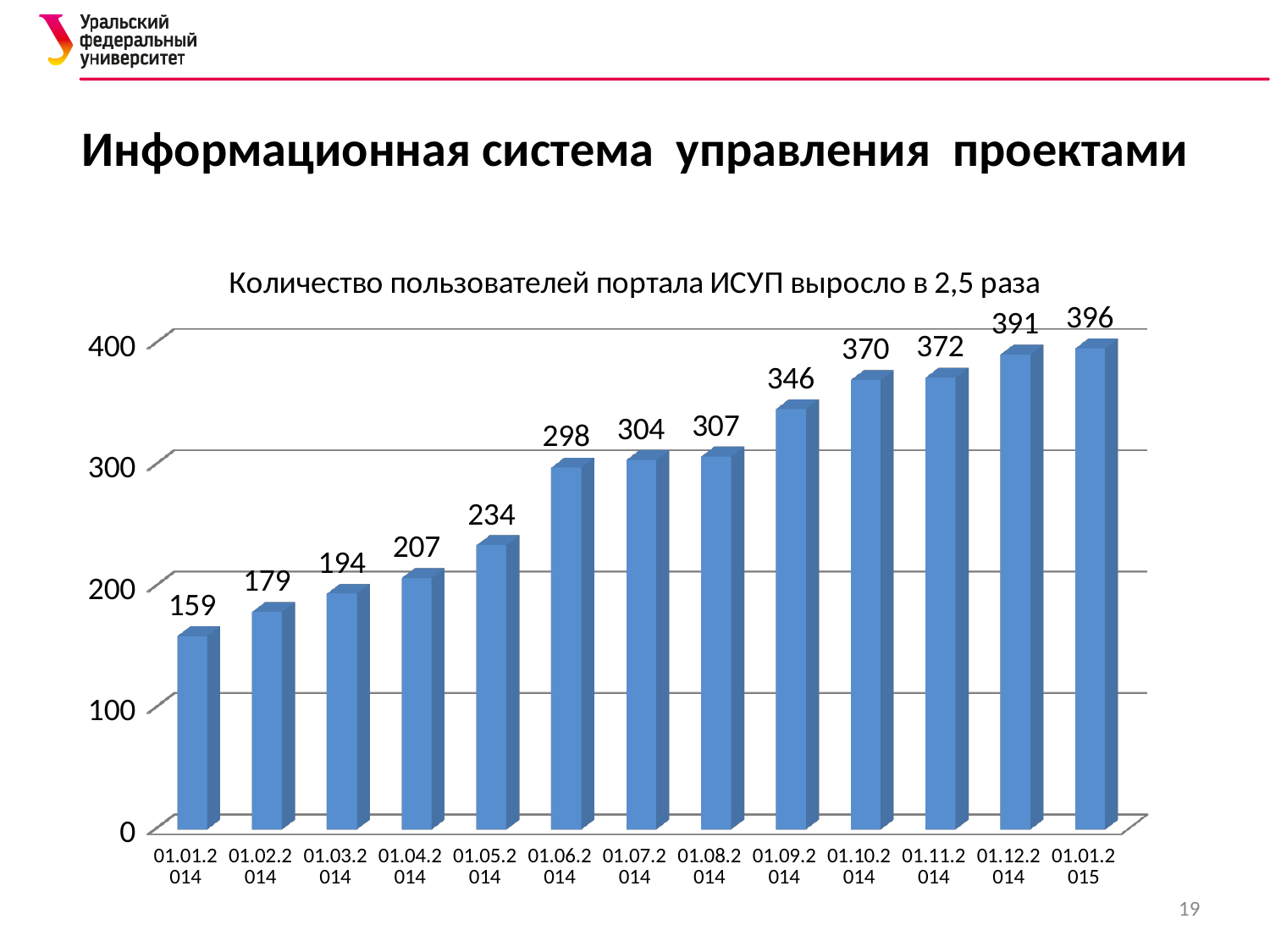
What is the value for 01.06.2014? 298 What is the difference between the values for 01.06.2014 and 01.05.2014? 64 Which date has the lowest value? 01.01.2014 What is the value for 01.01.2015? 396 What kind of chart is shown on the slide? bar chart Is the value for 01.04.2014 greater or less than 300? less How many dates are shown on the x axis? 13 What is the value for 01.01.2014? 159 Do the values rise or fall from 01.01.2014 to 01.01.2015? rise Which is larger, the value for 01.09.2014 or the value for 01.08.2014? 01.09.2014 Which date has the highest value? 01.01.2015 What is the difference between the values for 01.01.2015 and 01.01.2014? 237